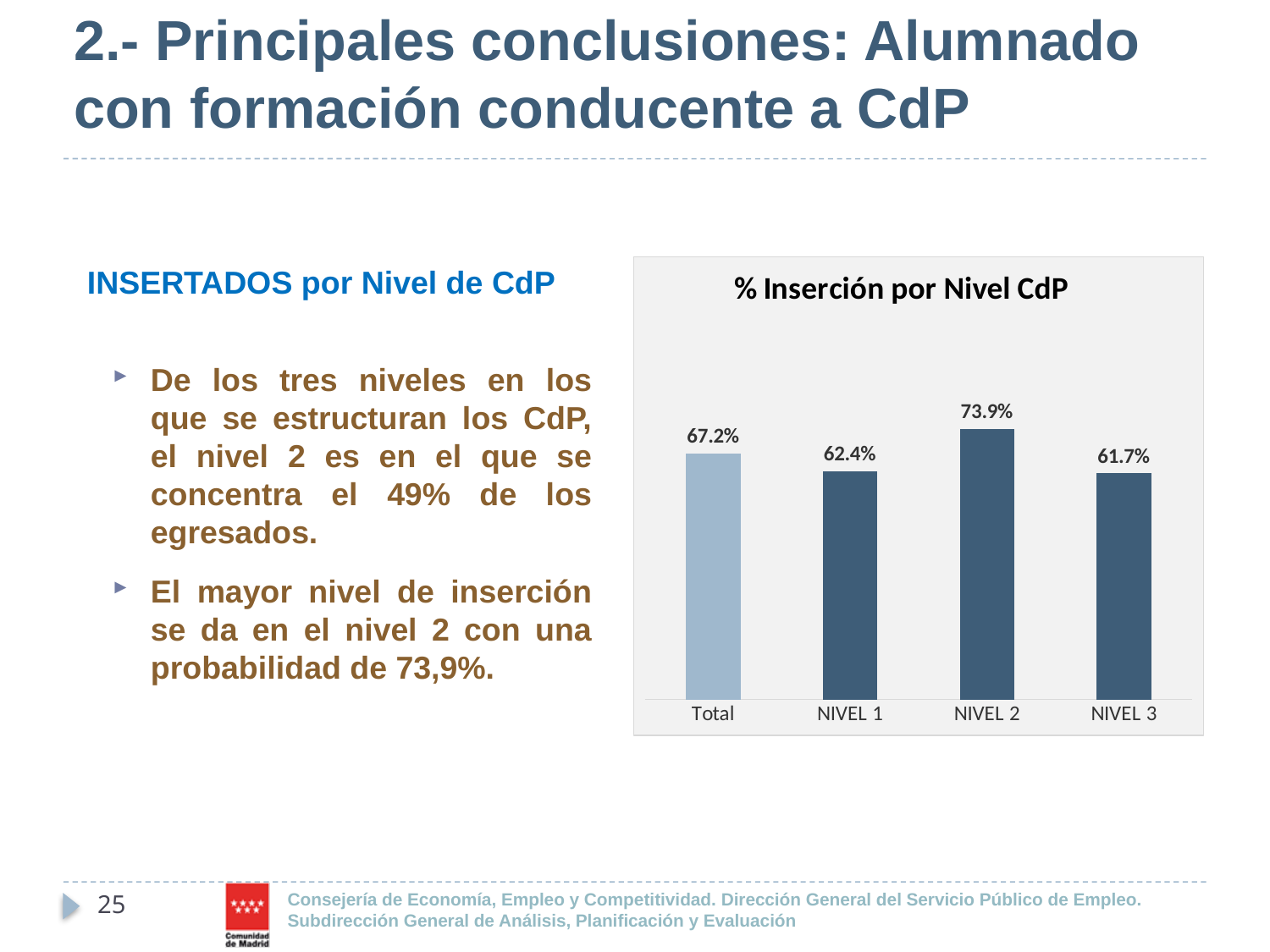
What is the value for NIVEL 2 in the chart? 73.9% What is the value for NIVEL 3 in the chart? 61.7% Which category has the lowest value in the chart? NIVEL 3 How many categories are shown in the chart? 4 What is the value for NIVEL 1 in the chart? 62.4% What is the difference between the values for Total and NIVEL 3? 5.5% What is the value for Total in the chart? 67.2% Which category has the highest value in the chart? NIVEL 2 Which is larger, the value for Total or the value for NIVEL 1? Total What is the difference between the values for NIVEL 2 and NIVEL 1? 11.5% What is the title of the chart? % Inserción por Nivel CdP What kind of chart is shown on the slide? Bar chart